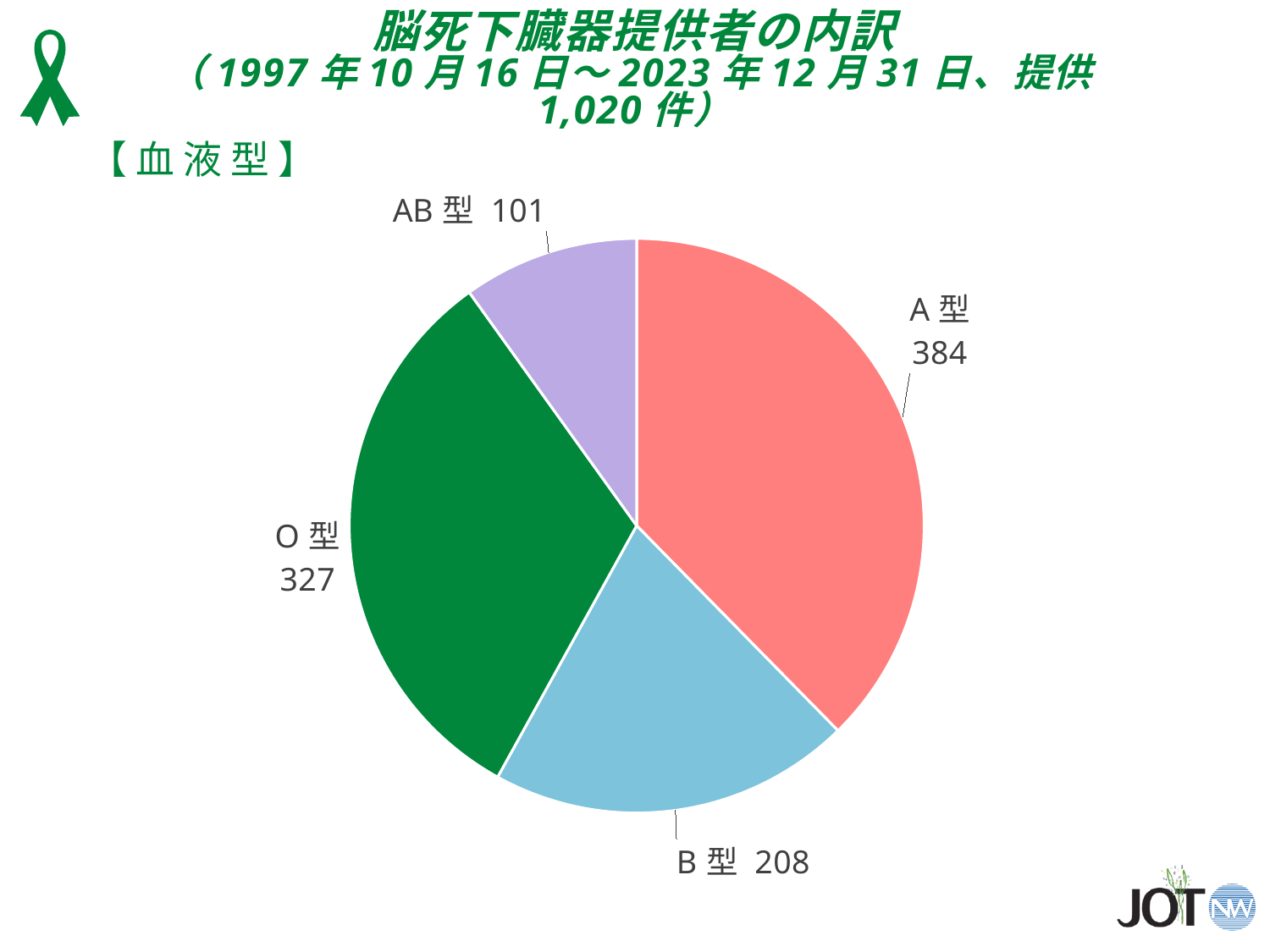
What is the value for A型 in the pie chart? 384 What is the value for AB型 in the pie chart? 101 Which blood type has the largest slice in the pie chart? A型 What kind of chart is shown on the slide? Pie chart How many slices does the pie chart have? 4 What is the value for O型 in the pie chart? 327 Which is larger, the value for O型 or the value for B型? O型 What is the difference between the values for A型 and O型? 57 What is the value for B型 in the pie chart? 208 What is the total of all four slices in the pie chart? 1,020 What is the difference between the values for B型 and AB型? 107 Which blood type has the smallest slice in the pie chart? AB型